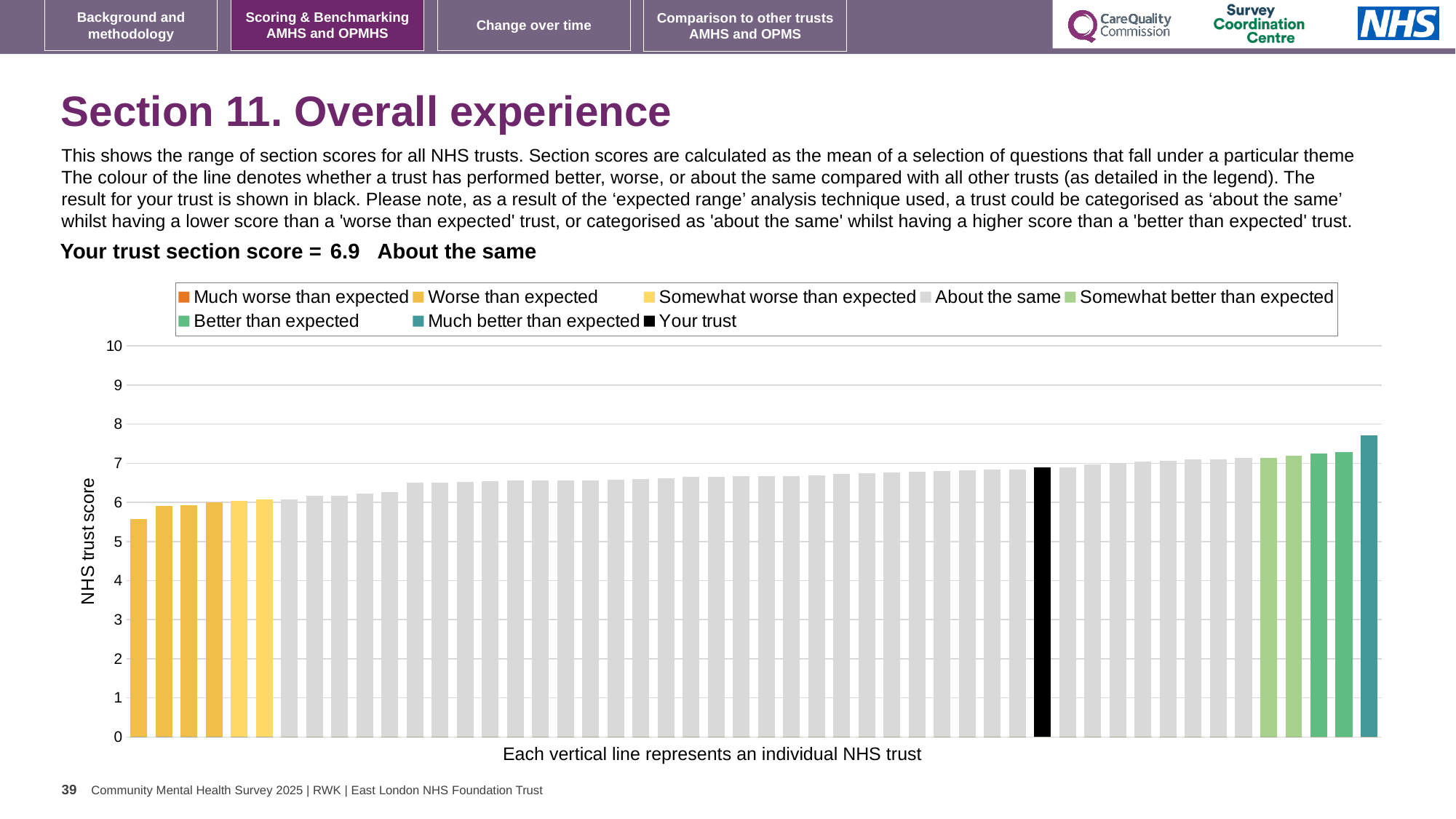
Is the value of the black 'Your trust' bar greater or less than 6? greater What kind of chart is shown on the slide? bar chart Which category is your trust placed in for this section? About the same Is the value of the tallest bar greater or less than 8? less What is the section score for your trust shown on the slide? 6.9 How many entries does the chart legend list? 8 How many bars are coloured as 'Much better than expected'? 1 What is the label on the vertical axis of the chart? NHS trust score What colour is the bar representing your trust? black Is the value of the shortest bar greater or less than 6? less Do the bar values rise or fall from left to right along the x axis? rise Which legend category does the tallest bar belong to? Much better than expected